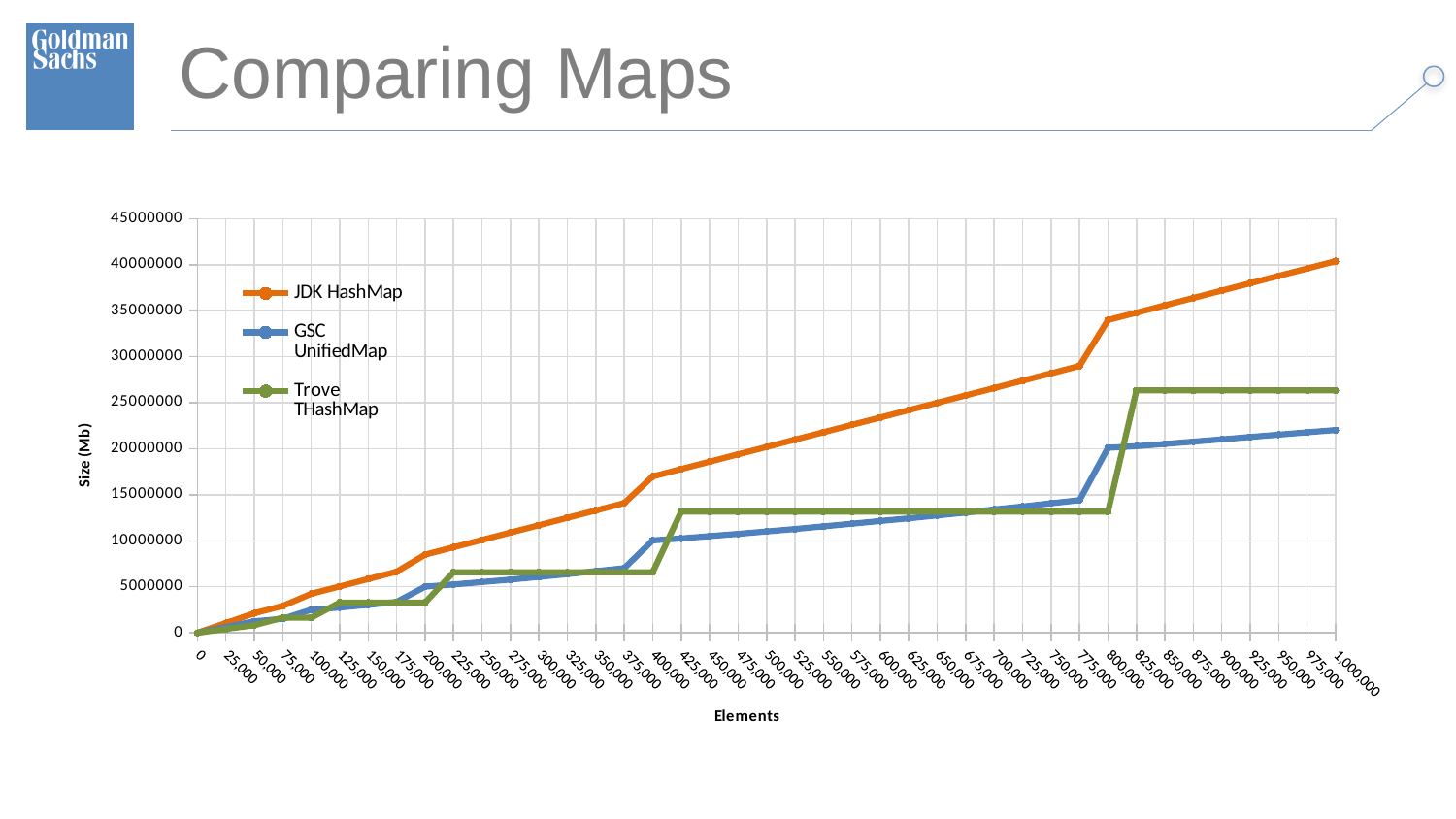
Does the JDK HashMap line rise or fall as the number of elements increases? rises How many series does the legend list? 3 Is the value for JDK HashMap at 1,000,000 elements greater or less than 35000000? greater Which series has the lowest value at 1,000,000 elements? GSC UnifiedMap Which series has the highest value at 1,000,000 elements? JDK HashMap What is the label on the vertical axis? Size (Mb) Is the value for Trove THashMap at 1,000,000 elements greater or less than 25000000? greater What is the title of the chart? Comparing Maps Is the value for JDK HashMap at 500,000 elements greater or less than 15000000? greater At 1,000,000 elements, which is larger: JDK HashMap or GSC UnifiedMap? JDK HashMap What kind of chart is shown on the slide? line chart